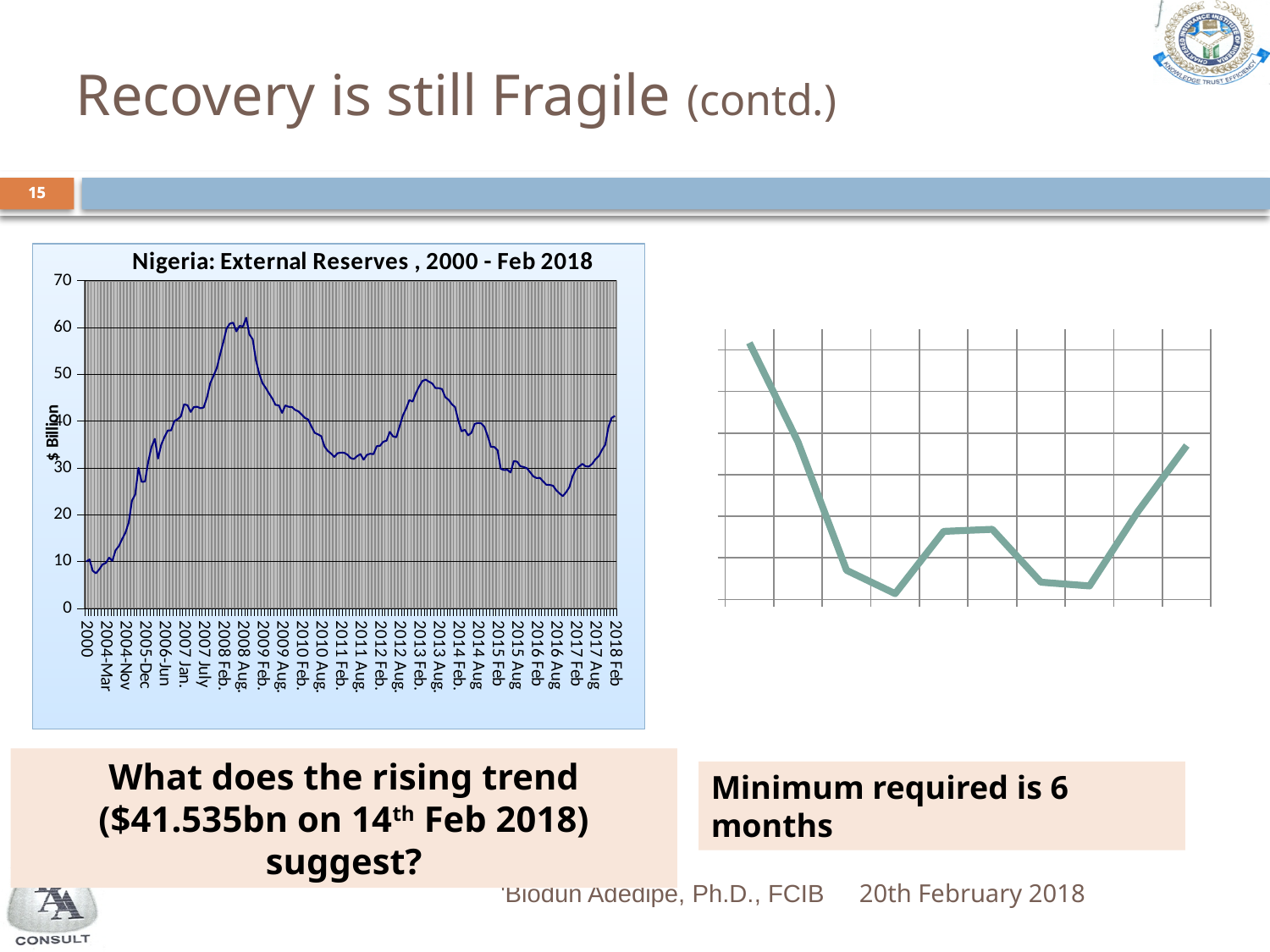
What kind of chart is the untitled chart on the right of the slide? line chart What is the title of the chart on the left of the slide? Nigeria: External Reserves , 2000 - Feb 2018 In the left chart 'Nigeria: External Reserves, 2000 - Feb 2018', what is the label on the vertical axis? $ Billion In the left chart 'Nigeria: External Reserves, 2000 - Feb 2018', what is the highest value shown on the vertical axis? 70 In the left chart 'Nigeria: External Reserves, 2000 - Feb 2018', is the value at 2000 greater or less than 20? less What kind of chart is the left chart, 'Nigeria: External Reserves, 2000 - Feb 2018'? line chart In the left chart 'Nigeria: External Reserves, 2000 - Feb 2018', is the value at 2016 Aug greater or less than 30? less In the left chart 'Nigeria: External Reserves, 2000 - Feb 2018', which is larger: the value at 2008 Aug or the value at 2018 Feb? 2008 Aug In the left chart 'Nigeria: External Reserves, 2000 - Feb 2018', is the peak value around 2008 Aug greater or less than 50? greater In the left chart 'Nigeria: External Reserves, 2000 - Feb 2018', do the values rise or fall between 2016 Aug and 2018 Feb? rise In the left chart 'Nigeria: External Reserves, 2000 - Feb 2018', do the values rise or fall between 2008 Aug and 2011 Feb? fall